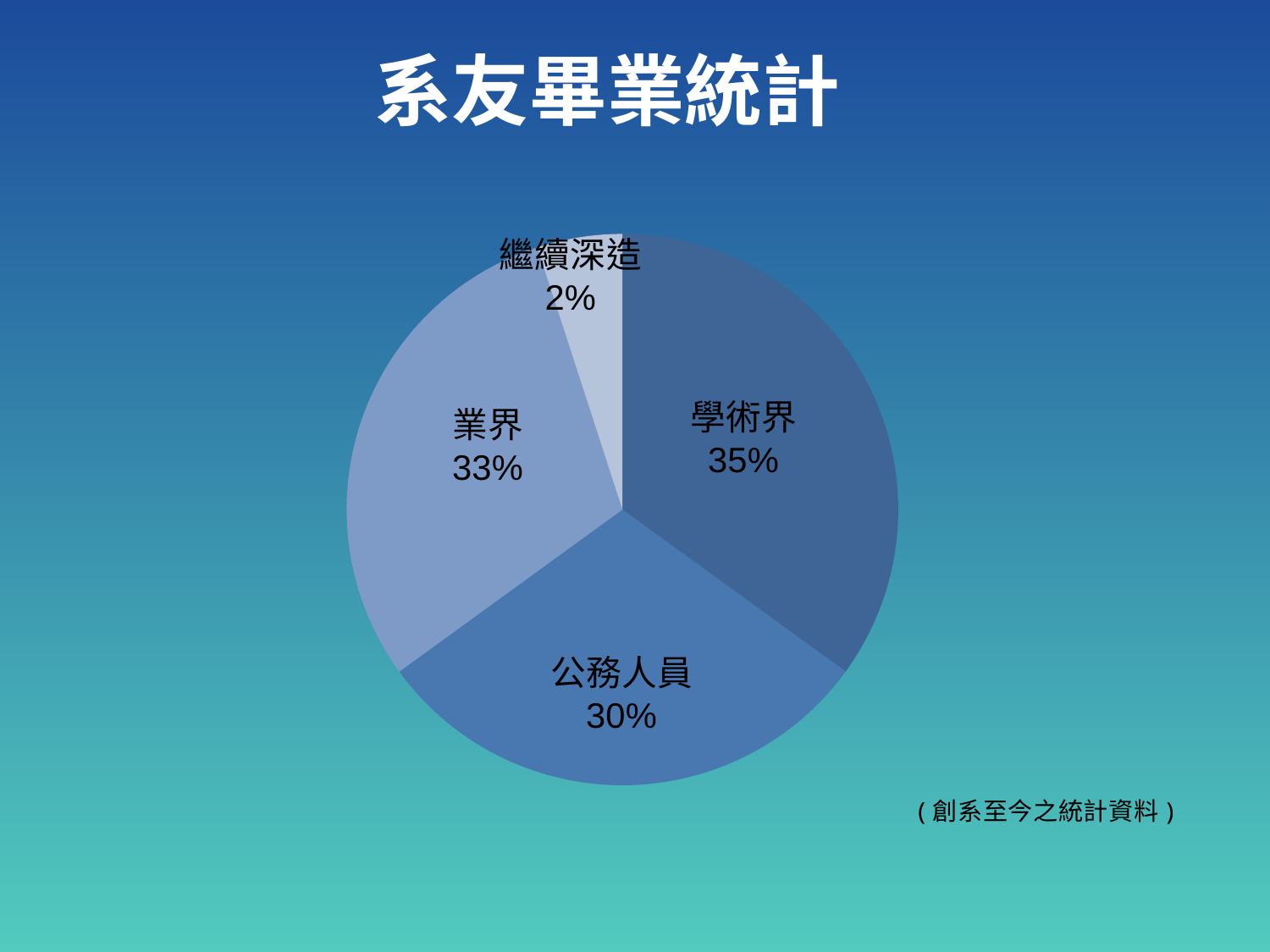
What share of the pie does 學術界 represent? 35% What share of the pie does 業界 represent? 33% Which category has the smallest share of the pie? 繼續深造 How many categories are shown in the pie chart? 4 What share of the pie does 繼續深造 represent? 2% Which category has the largest share of the pie? 學術界 Which is larger, the share for 業界 or the share for 公務人員? 業界 What is the difference in percentage points between 學術界 and 公務人員? 5 What kind of chart is shown on the slide? pie chart What is the difference in percentage points between 業界 and 繼續深造? 31 What is the title of the chart on the slide? 系友畢業統計 What share of the pie does 公務人員 represent? 30%